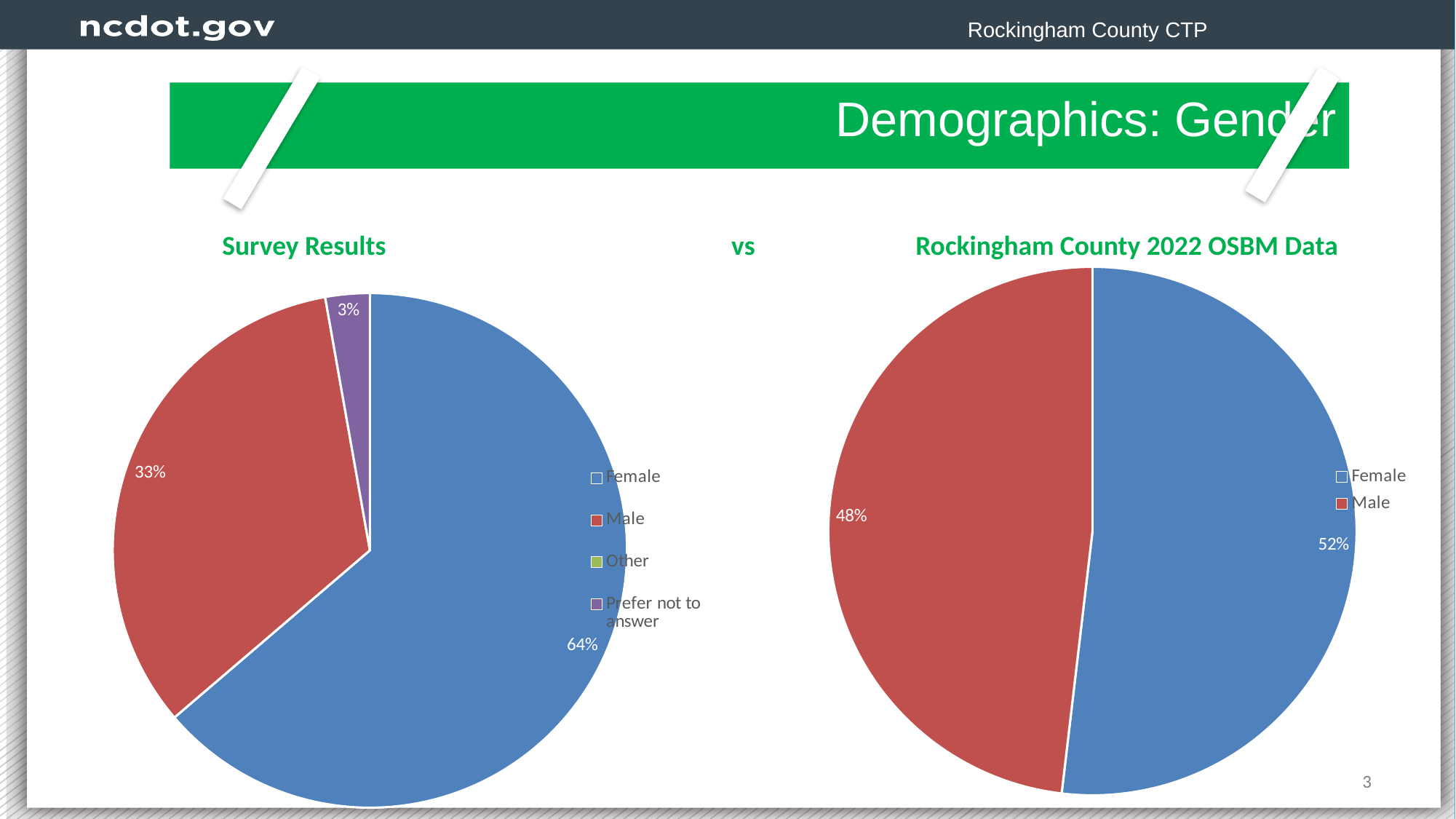
What type of chart is used for the Survey Results? Pie chart In the Survey Results pie chart, what is the difference between the Female and Male shares? 31% In the Survey Results pie chart, what share of respondents are Male? 33% Is the Female share larger in the Survey Results chart or in the Rockingham County 2022 OSBM Data chart? Survey Results In the Rockingham County 2022 OSBM Data pie chart, what is the difference between the Female and Male shares? 4% In the Survey Results pie chart, what share of respondents chose Prefer not to answer? 3% How many entries does the legend of the Survey Results pie chart list? 4 In the Rockingham County 2022 OSBM Data pie chart, what share is Male? 48% In the Rockingham County 2022 OSBM Data pie chart, what share is Female? 52% In the Survey Results pie chart, which category has the largest slice? Female In the Rockingham County 2022 OSBM Data pie chart, which category has the smaller slice? Male In the Survey Results pie chart, what share of respondents are Female? 64%